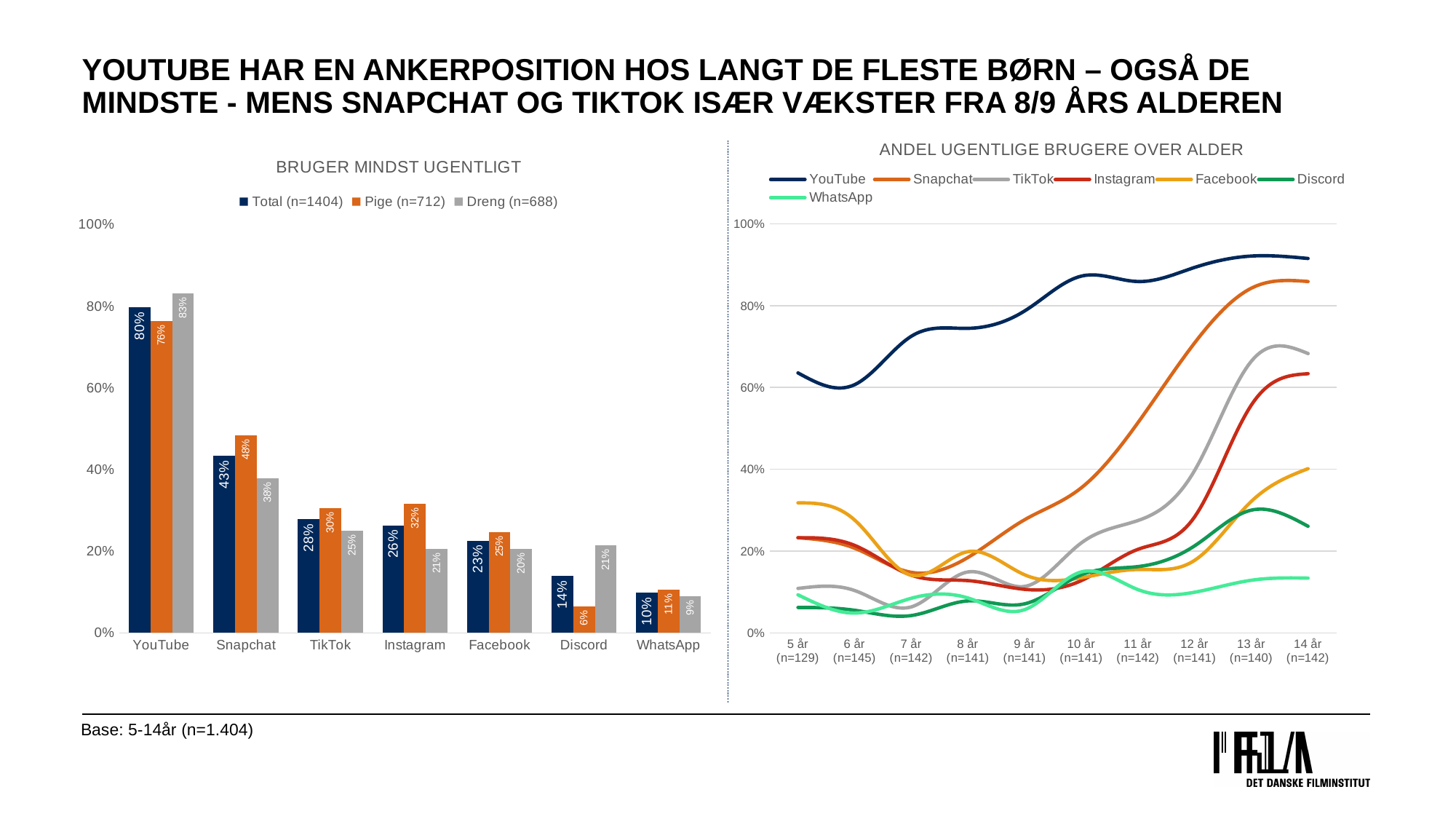
How many series does the legend of the 'BRUGER MINDST UGENTLIGT' chart list? 3 In the 'BRUGER MINDST UGENTLIGT' chart, what is the Dreng value for Discord? 21% In the 'BRUGER MINDST UGENTLIGT' chart, what is the Total value for YouTube? 80% How many platforms are shown on the x axis of the 'BRUGER MINDST UGENTLIGT' chart? 7 In the 'BRUGER MINDST UGENTLIGT' chart, which is larger for Instagram: the Pige value or the Dreng value? Pige In the 'ANDEL UGENTLIGE BRUGERE OVER ALDER' chart, is the YouTube value at 14 år greater or less than 80%? greater How many series does the legend of the 'ANDEL UGENTLIGE BRUGERE OVER ALDER' chart list? 7 In the 'BRUGER MINDST UGENTLIGT' chart, which platform has the lowest Pige value? Discord In the 'BRUGER MINDST UGENTLIGT' chart, what is the Pige value for Snapchat? 48% What kind of chart is 'ANDEL UGENTLIGE BRUGERE OVER ALDER'? Line chart In the 'BRUGER MINDST UGENTLIGT' chart, what is the difference between the Pige and Dreng values for Snapchat? 10% In the 'BRUGER MINDST UGENTLIGT' chart, which platform has the highest Total value? YouTube